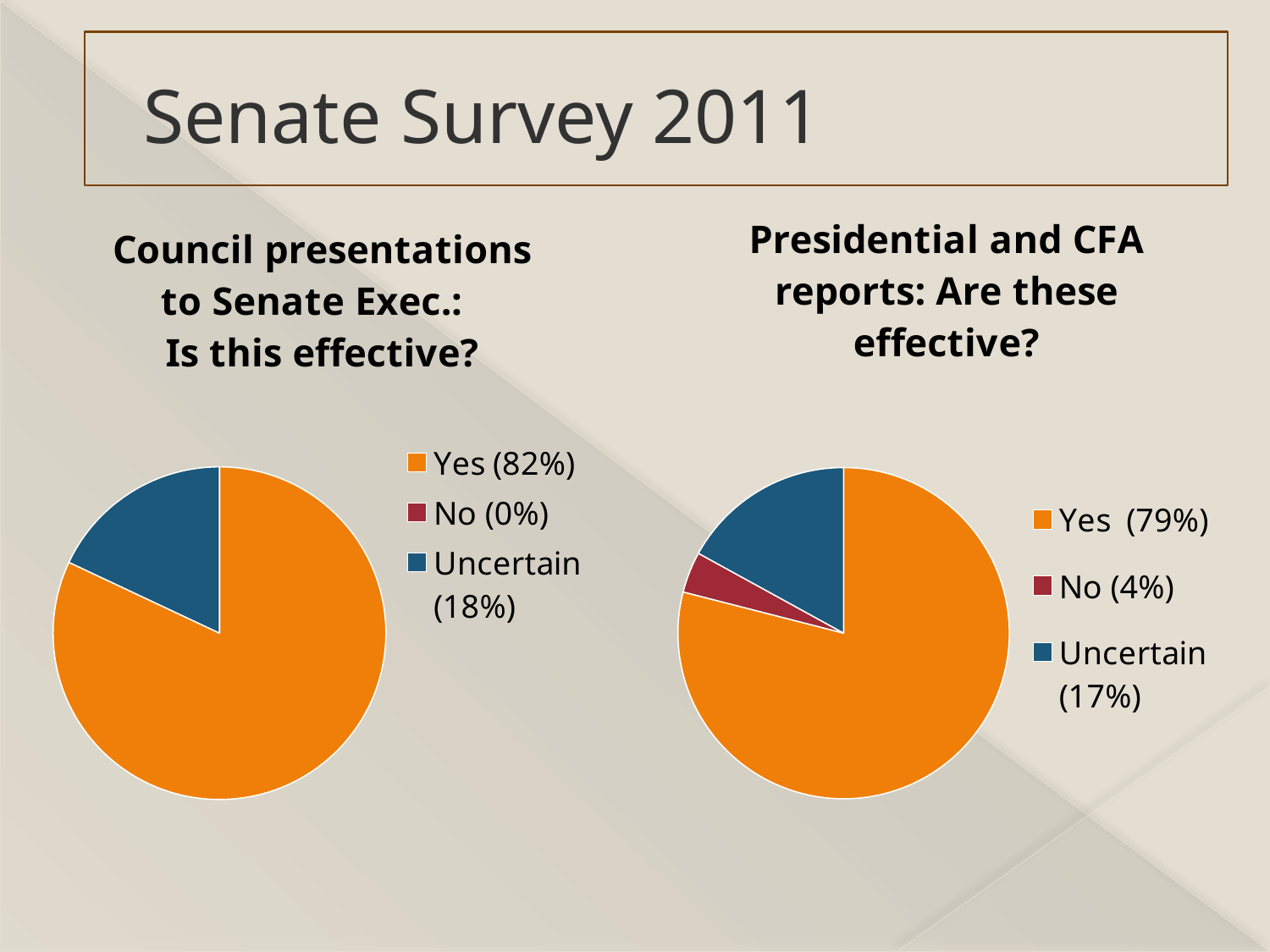
In the 'Presidential and CFA reports' chart, which response has the largest share? Yes In the 'Council presentations to Senate Exec.' chart, what share of responses is 'Uncertain'? 18% In the 'Presidential and CFA reports' chart, what share of responses is 'No'? 4% What type of chart is used on the left of the slide? Pie chart In the 'Presidential and CFA reports' chart, which response has the smallest share? No In the 'Presidential and CFA reports' chart, what share of responses is 'Yes'? 79% How many entries does the legend of the 'Presidential and CFA reports' chart list? 3 In the 'Council presentations to Senate Exec.' chart, what is the difference between the 'Yes' and 'Uncertain' shares? 64% Which chart has the larger 'Yes' share, the 'Council presentations to Senate Exec.' chart or the 'Presidential and CFA reports' chart? Council presentations to Senate Exec.